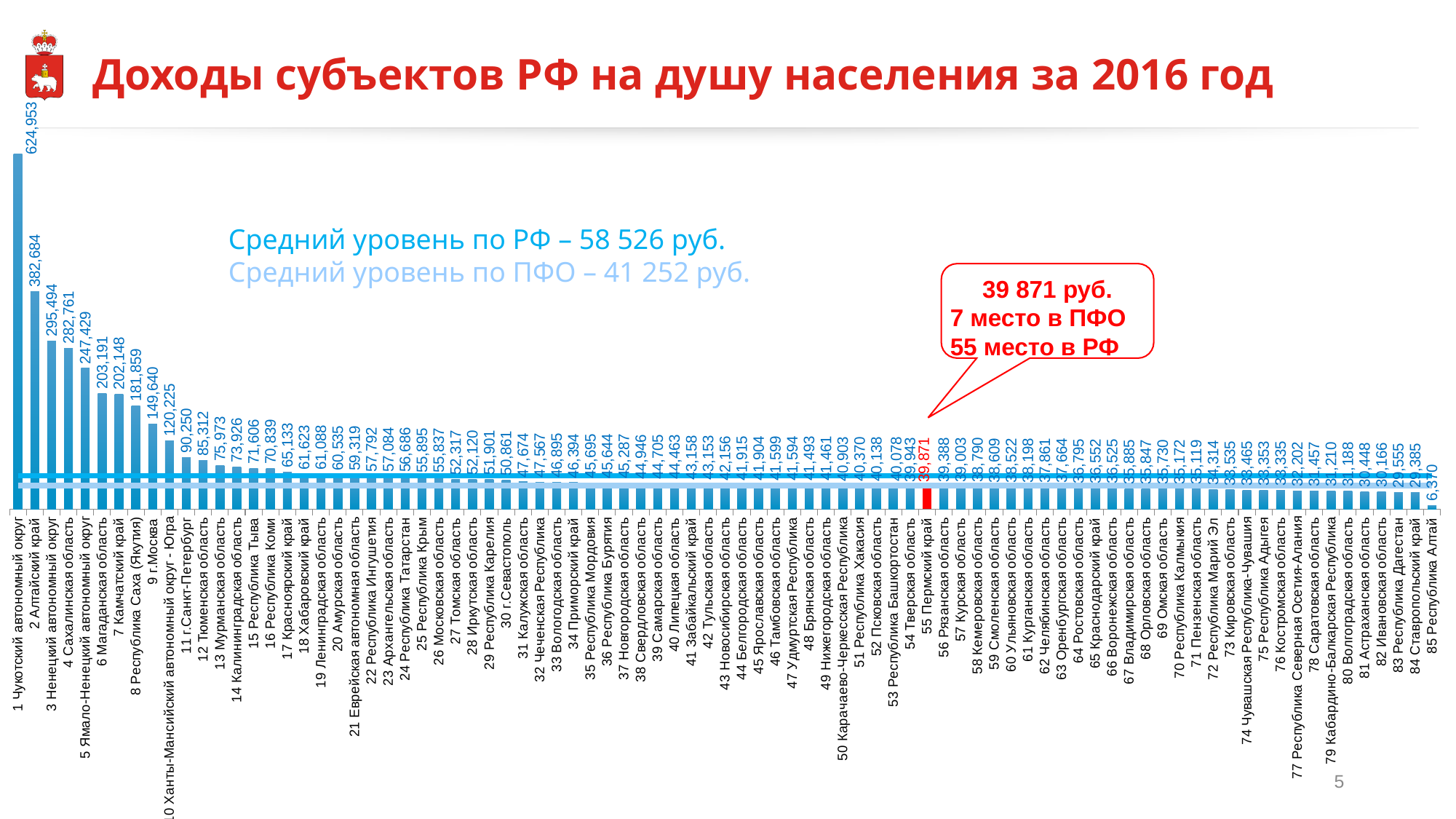
Which region has the highest value on the chart? 1 Чукотский автономный округ What is the value for 9 г.Москва? 149,640 What is the difference between the values for 1 Чукотский автономный округ and 2 Алтайский край? 242,269 What kind of chart is shown on the slide? bar chart Do the values rise or fall moving from left to right along the x axis? fall What is the difference between the values for 9 г.Москва and 11 г.Санкт-Петербург? 59,390 Which is larger, the value for 12 Тюменская область or the value for 13 Мурманская область? 12 Тюменская область According to the slide, what is the average level for the RF (Средний уровень по РФ)? 58 526 руб. What is the value for 85 Республика Алтай? 6,370 What is the value for 1 Чукотский автономный округ? 624,953 Which region has the lowest value on the chart? 85 Республика Алтай What is the value for 55 Пермский край? 39,871